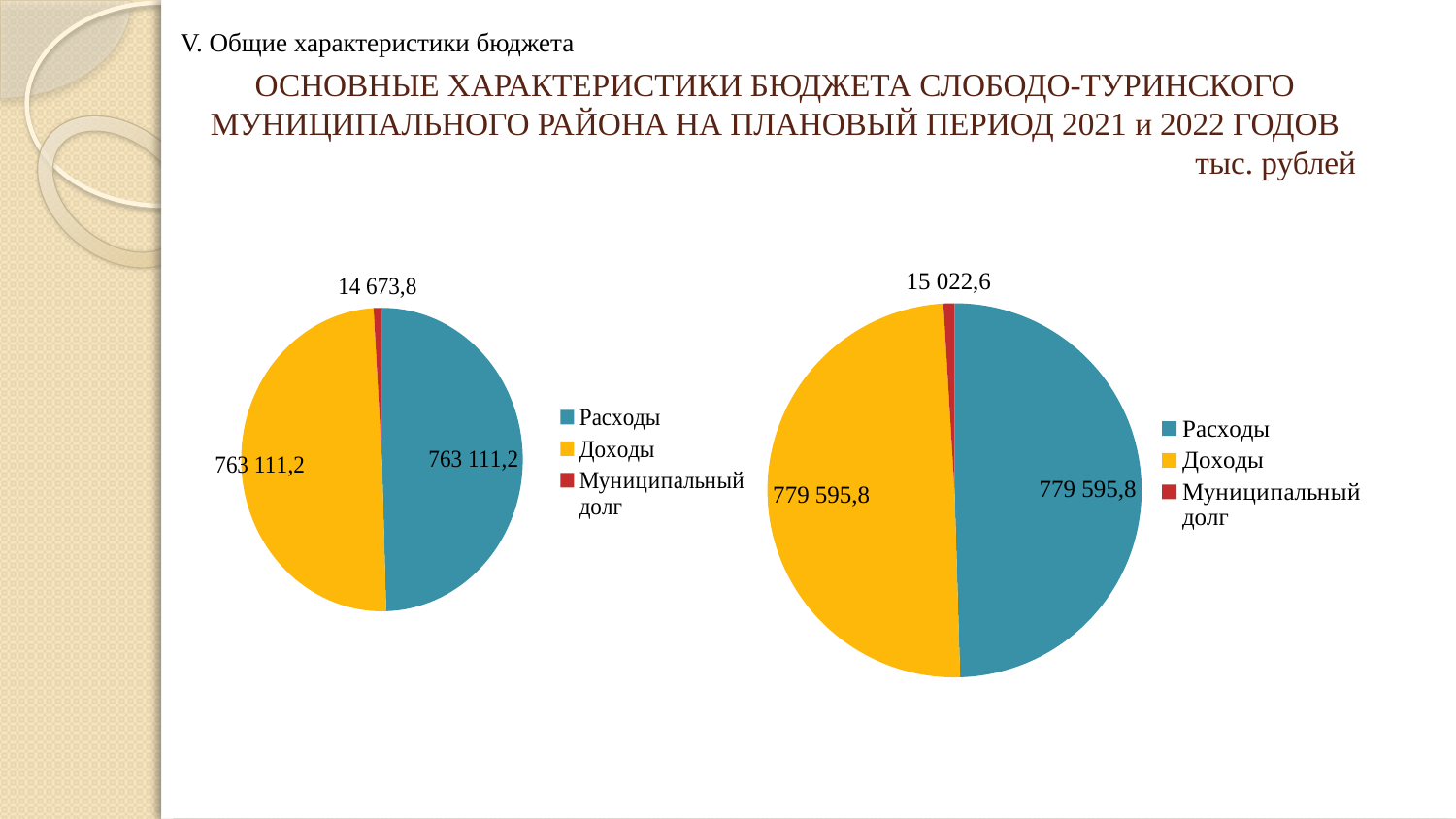
In the left pie chart, what is the difference between Расходы and Муниципальный долг? 748 437,4 In the right pie chart, what is the value for Муниципальный долг? 15 022,6 In the right pie chart, what colour is the Доходы slice? Yellow In the right pie chart, which category has the smallest slice? Муниципальный долг In the left pie chart, which category has the smallest slice? Муниципальный долг What kind of chart is shown on the right side of the slide? Pie chart What is the difference between the Муниципальный долг value in the right pie chart and the one in the left pie chart? 348,8 How many categories does the legend of the left pie chart list? 3 In the left pie chart, what is the value for Расходы? 763 111,2 In the right pie chart, what is the value for Доходы? 779 595,8 In the left pie chart, what is the value for Муниципальный долг? 14 673,8 In the right pie chart, which is larger, Расходы or Муниципальный долг? Расходы